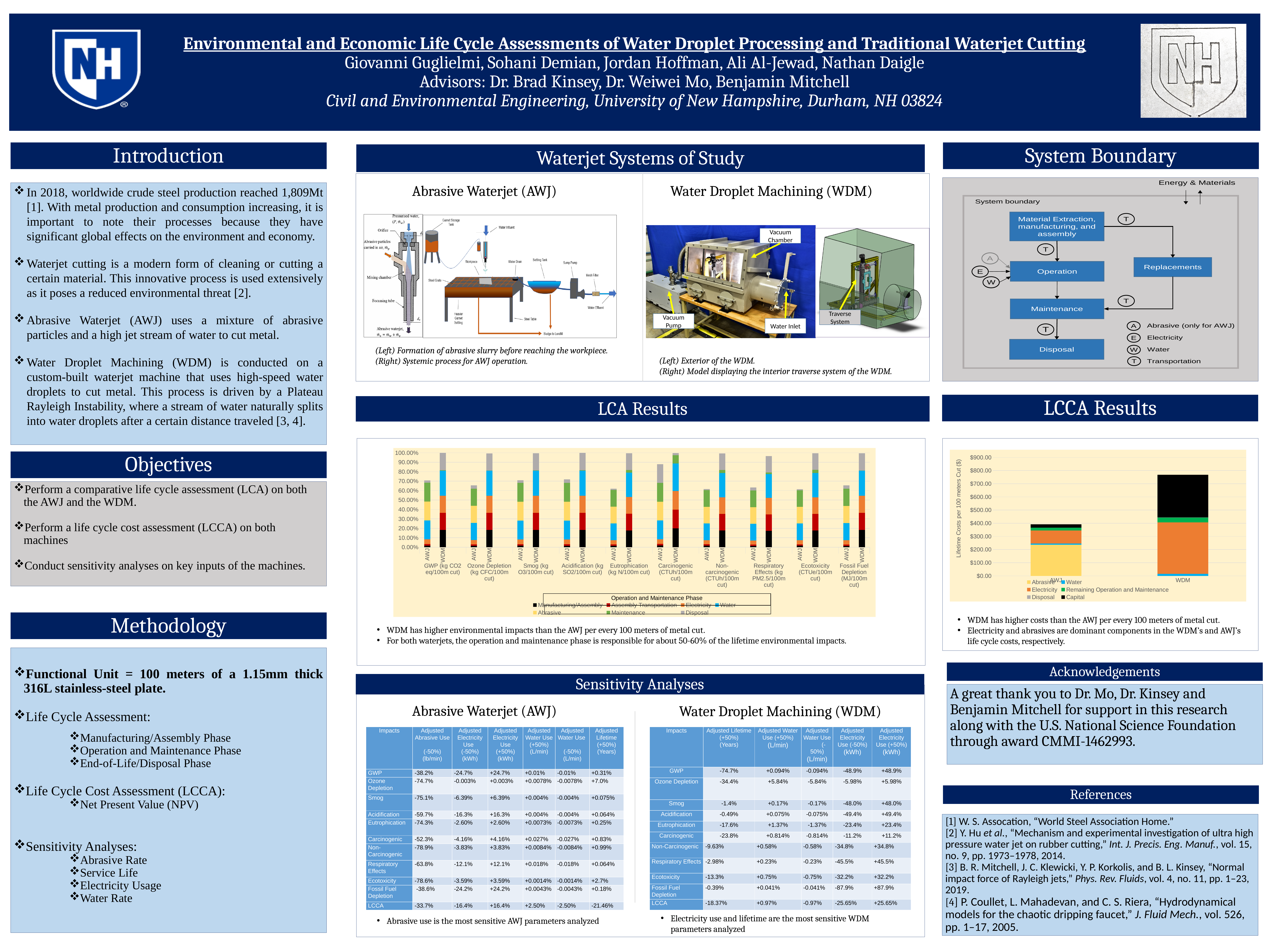
How many series does the legend of the LCA Results chart list? 7 In the LCA Results chart, for GWP, which bar is taller, AWJ or WDM? WDM What kind of chart is the LCA Results chart? bar chart In the LCA Results chart, is the total of the AWJ bar for GWP greater or less than 80.00%? less How many series does the legend of the LCCA Results chart list? 6 In the LCCA Results chart, is the total lifetime cost for AWJ greater or less than $500.00? less In the LCCA Results chart, how many machines (categories) are shown on the x axis? 2 What is the y-axis label of the LCCA Results chart? Lifetime Costs per 100 meters Cut ($) In the LCCA Results chart, which machine has the higher total lifetime cost, AWJ or WDM? WDM In the LCA Results chart, how many environmental impact categories are shown on the x axis? 10 In the LCCA Results chart, is the total lifetime cost for WDM greater or less than $600.00? greater What kind of chart is the LCCA Results chart? bar chart